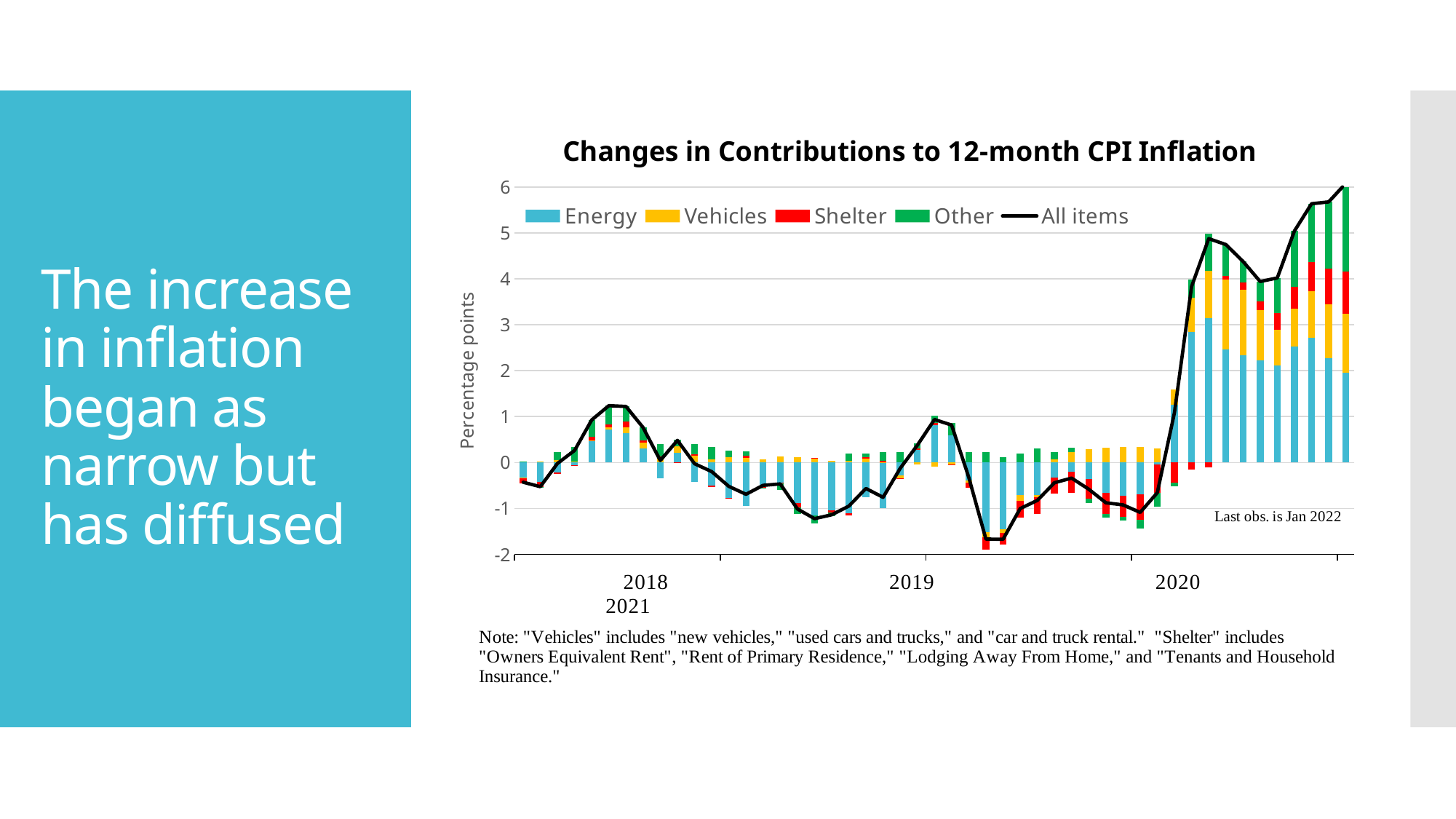
Is the All items value at the last observation larger or smaller than its peak in 2018? larger According to the annotation on the chart, what is the last observation? Jan 2022 What is the title of the chart? Changes in Contributions to 12-month CPI Inflation How many series does the chart's legend list? 5 Which series is drawn as a black line rather than stacked bars? All items Which year on the x axis contains the lowest point of the All items line? 2020 Does the All items line generally rise or fall from the start of 2020 to the last observation? rise What kind of chart is shown on the slide? Stacked bar chart with a line overlay Is the value of the All items line at the last observation (Jan 2022) greater or less than 5? greater Is the peak of the All items line in 2018 greater or less than 2? less